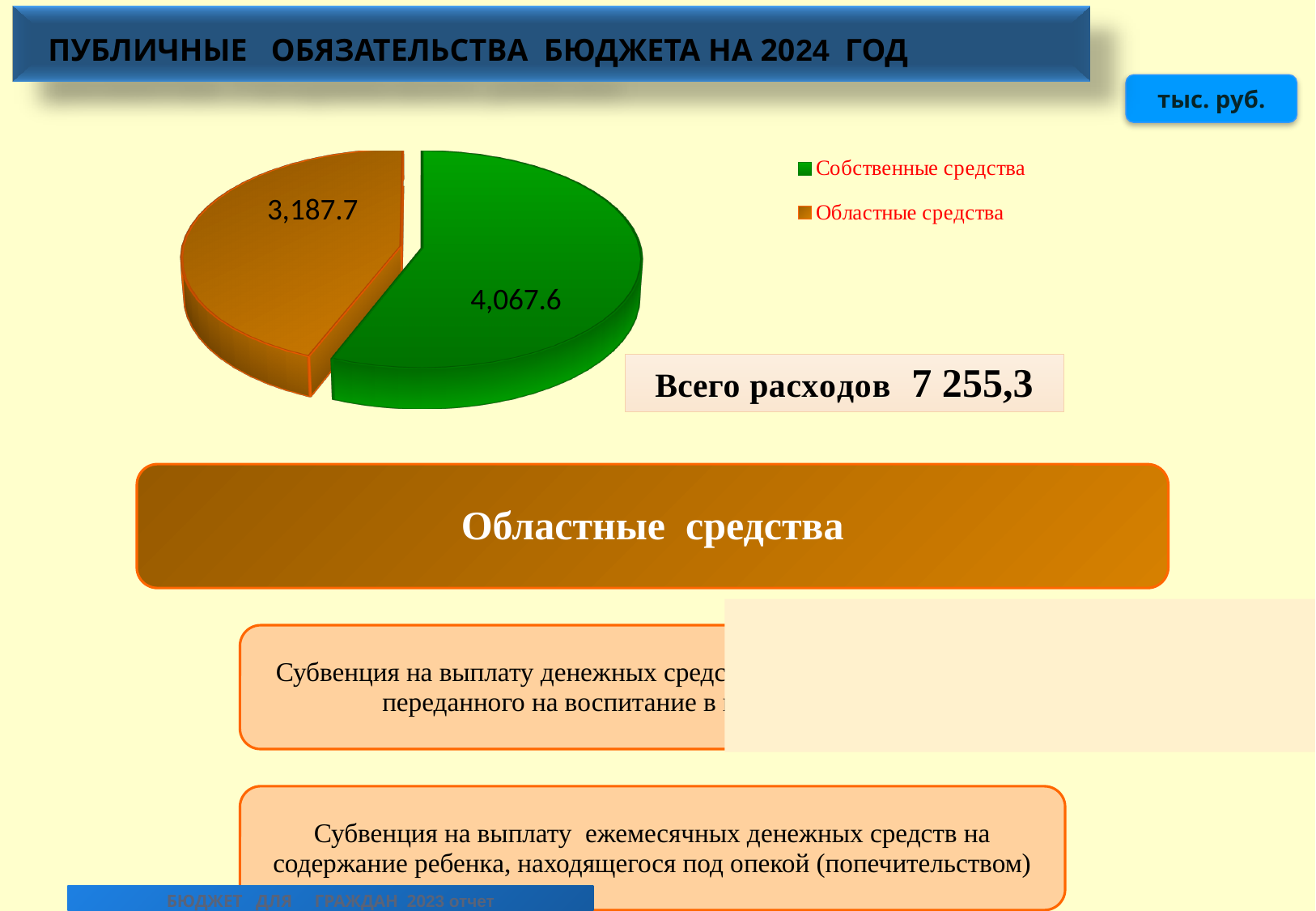
What kind of chart is shown on the slide? pie chart What is the value for Областные средства in the pie chart? 3,187.7 Which is larger: Собственные средства or Областные средства? Собственные средства What is the difference between the values for Собственные средства and Областные средства? 879.9 What total expenditure (Всего расходов) is shown next to the pie chart? 7 255,3 How many entries does the legend of the pie chart list? 2 What unit of measurement is indicated for the values on the slide? тыс. руб. Which slice of the pie chart is the smallest? Областные средства What is the value for Собственные средства in the pie chart? 4,067.6 How many slices does the pie chart have? 2 Which slice of the pie chart is the largest? Собственные средства What colour is the slice for Областные средства? orange